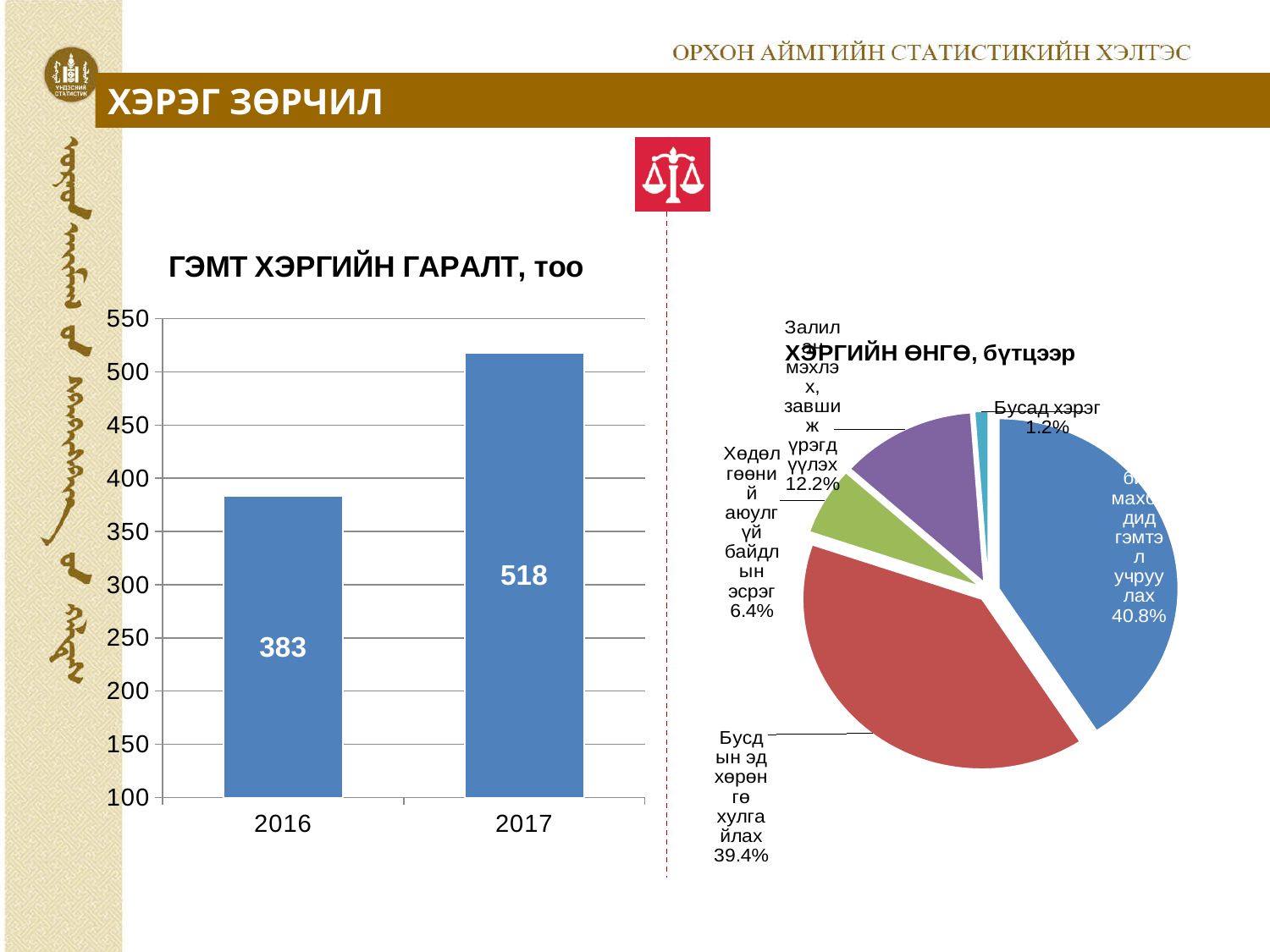
In the bar chart 'ГЭМТ ХЭРГИЙН ГАРАЛТ, тоо', which year has the higher value? 2017 In the bar chart 'ГЭМТ ХЭРГИЙН ГАРАЛТ, тоо', what is the difference between the 2017 and 2016 values? 135 What type of chart is the right chart 'ХЭРГИЙН ӨНГӨ, бүтцээр'? pie chart In the bar chart 'ГЭМТ ХЭРГИЙН ГАРАЛТ, тоо', do the values rise or fall from 2016 to 2017? rise In the bar chart 'ГЭМТ ХЭРГИЙН ГАРАЛТ, тоо', what is the value for 2017? 518 In the pie chart 'ХЭРГИЙН ӨНГӨ, бүтцээр', what is the share of the largest slice? 40.8% How many bars are shown in the bar chart 'ГЭМТ ХЭРГИЙН ГАРАЛТ, тоо'? 2 What type of chart is the left chart 'ГЭМТ ХЭРГИЙН ГАРАЛТ, тоо'? bar chart In the pie chart 'ХЭРГИЙН ӨНГӨ, бүтцээр', which slice is the smallest? Бусад хэрэг In the pie chart 'ХЭРГИЙН ӨНГӨ, бүтцээр', what share does 'Бусдын эд хөрөнгө хулгайлах' have? 39.4% In the bar chart 'ГЭМТ ХЭРГИЙН ГАРАЛТ, тоо', what is the value for 2016? 383 In the pie chart 'ХЭРГИЙН ӨНГӨ, бүтцээр', what share does 'Хөдөлгөөний аюулгүй байдлын эсрэг' have? 6.4%